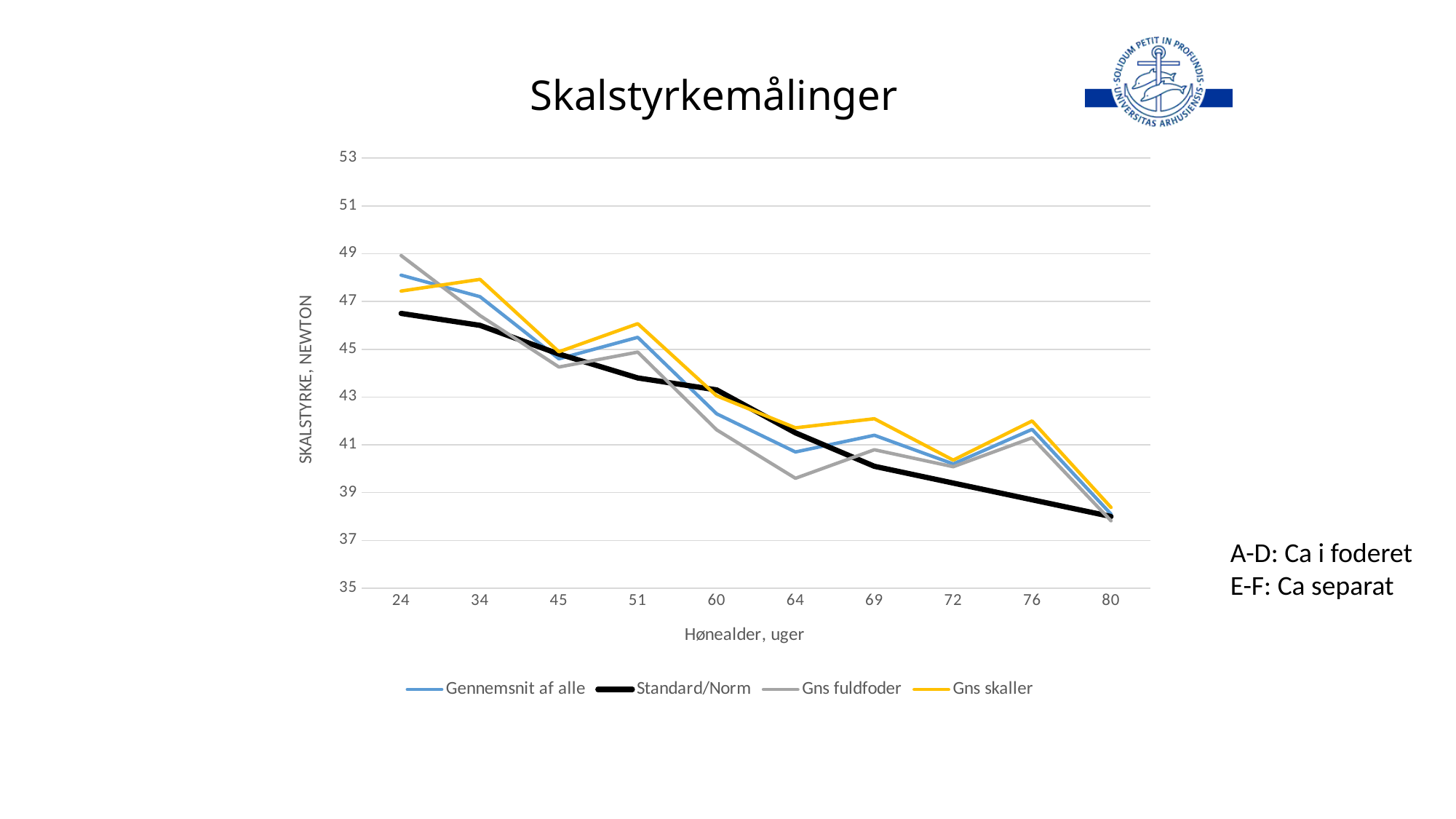
How many hen-age points are plotted along the x axis? 10 Which series has the highest value at 24 weeks? Gns fuldfoder Which series has the lowest value at 64 weeks? Gns fuldfoder Is the value for Standard/Norm at 80 weeks greater or less than 39? less How many series does the legend list? 4 What kind of chart is shown on the slide? line chart Is the value for Gns fuldfoder at 24 weeks greater or less than 47? greater What is the title of the chart? Skalstyrkemålinger Is the value for Gns fuldfoder at 64 weeks greater or less than 41? less Does the Standard/Norm series rise or fall as hen age increases from 24 to 80 weeks? fall What is the label of the y axis? SKALSTYRKE, NEWTON